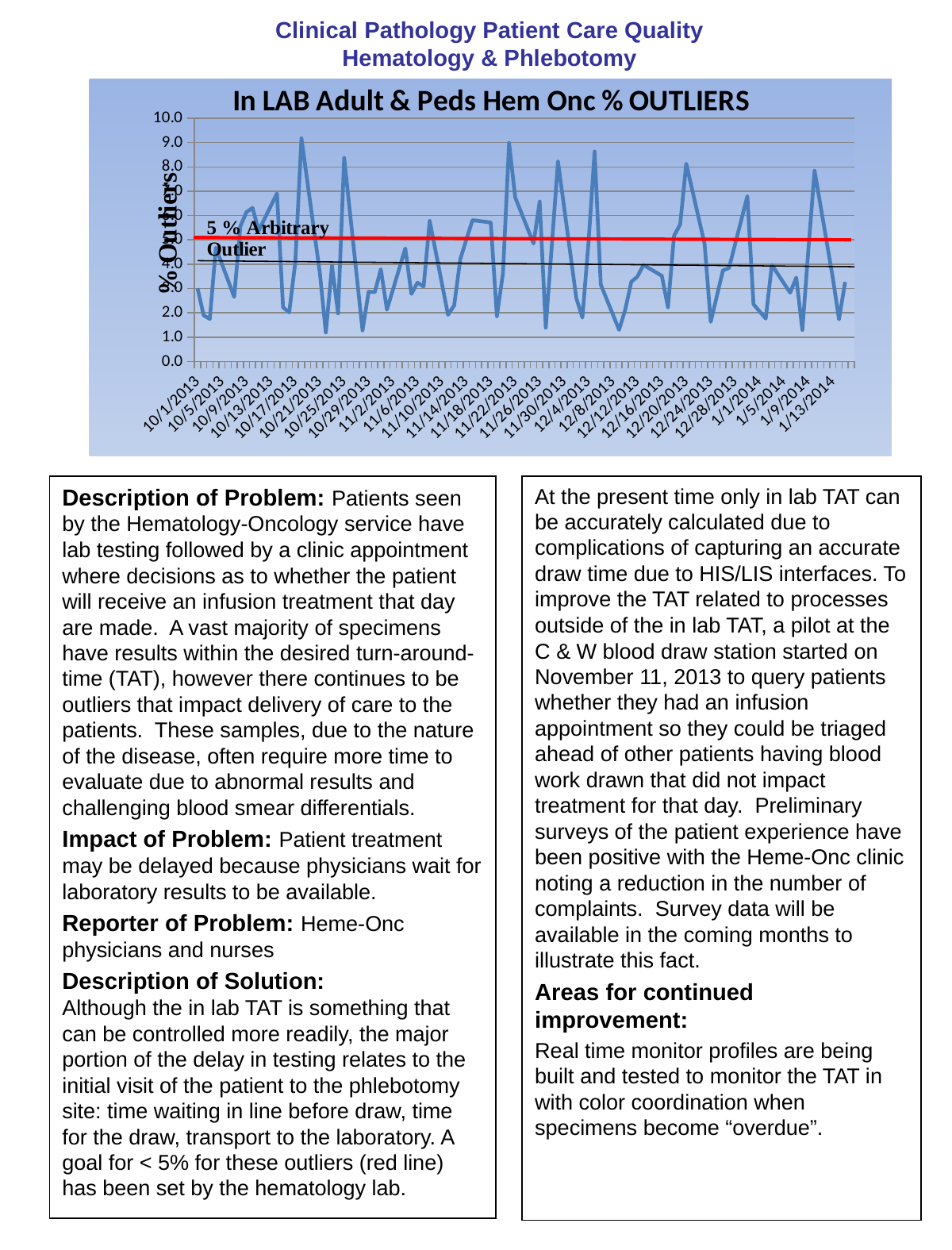
What is the title of the chart? In LAB Adult & Peds Hem Onc % OUTLIERS What value does the red horizontal line on the chart mark? 5 % Arbitrary Outlier Is the value for 10/1/2013 greater or less than 5.0? less What kind of chart is shown on the slide? line chart Is the value for 10/1/2013 greater or less than 2.0? greater